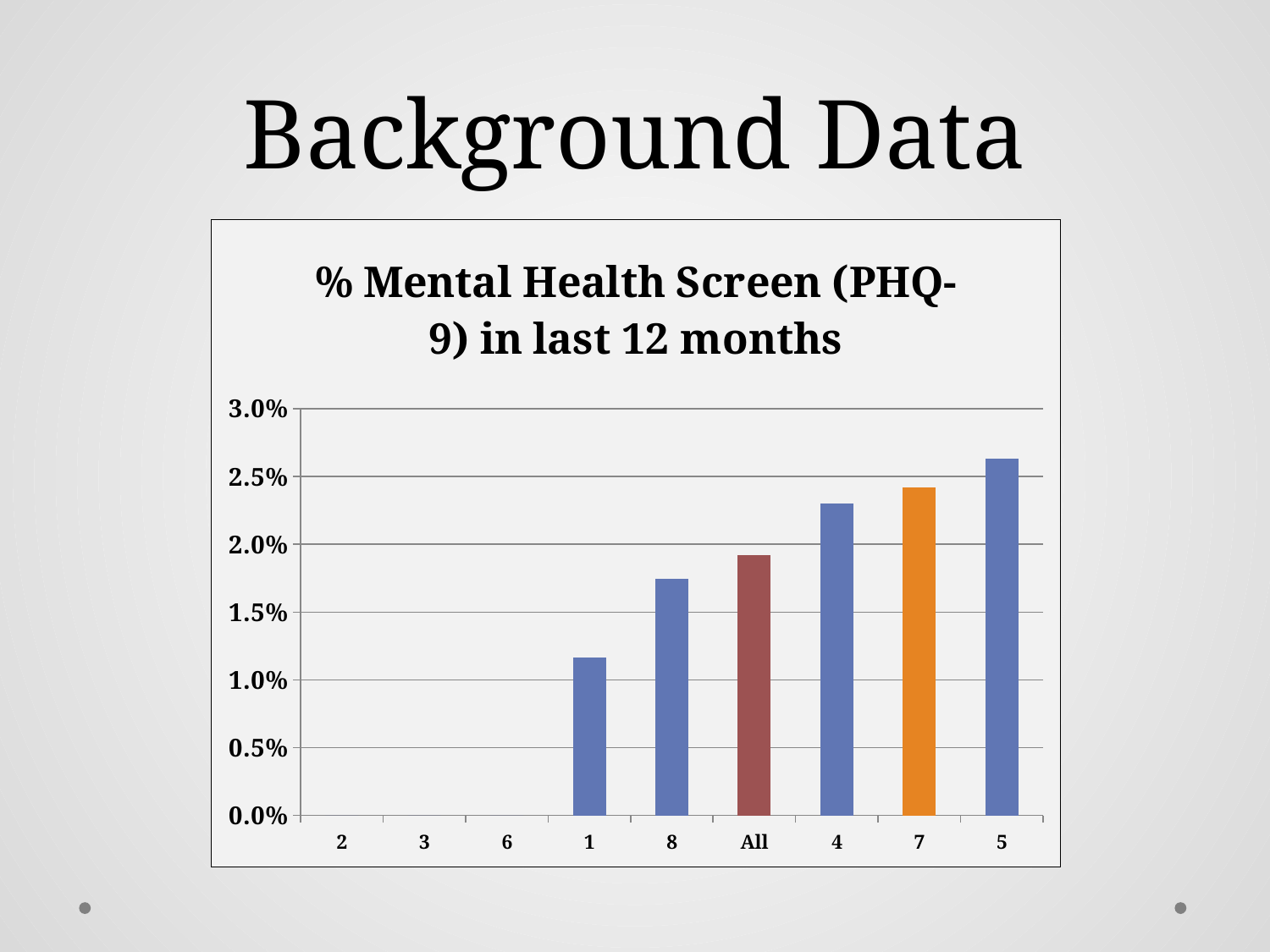
Do the bar values generally rise or fall from left to right along the x axis? rise Which category has the highest value in the chart? 5 Is the value for category 4 greater or less than 2.0%? greater Is the value for category 1 greater or less than 1.0%? greater Is the value for category 8 greater or less than 2.0%? less How many categories are shown on the x axis of the chart? 9 What colour is the bar for All? red What is the title of the chart? % Mental Health Screen (PHQ-9) in last 12 months What kind of chart is shown on the slide? bar chart Which has a larger value, category 8 or category 1? 8